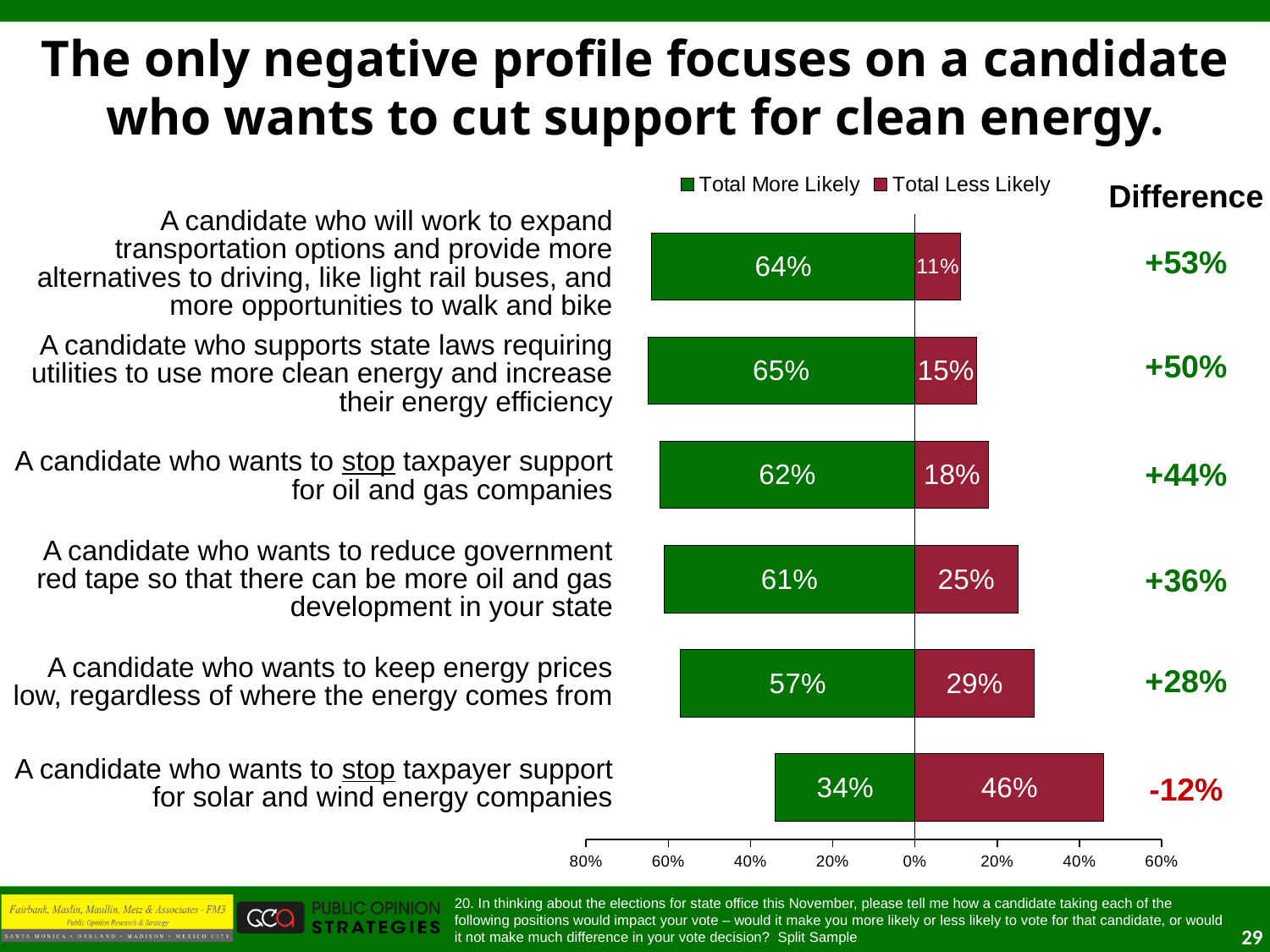
What is the Total Less Likely value for a candidate who wants to stop taxpayer support for solar and wind energy companies? 46% Which colour represents Total Less Likely in the chart? Red Which candidate position has the highest Total More Likely percentage? A candidate who supports state laws requiring utilities to use more clean energy and increase their energy efficiency What percentage of respondents said they would be more likely to vote for a candidate who supports state laws requiring utilities to use more clean energy? 65% What is the difference between Total More Likely and Total Less Likely for a candidate who wants to stop taxpayer support for oil and gas companies? +44% Which candidate position has the lowest Total Less Likely percentage? A candidate who will work to expand transportation options and provide more alternatives to driving Which is larger for a candidate who wants to stop taxpayer support for solar and wind energy companies: Total More Likely or Total Less Likely? Total Less Likely What type of chart is shown on the slide? Bar chart Which candidate position is the only one with a negative Difference value? A candidate who wants to stop taxpayer support for solar and wind energy companies How many candidate positions are shown in the chart? 6 What is the Total Less Likely value for a candidate who wants to keep energy prices low, regardless of where the energy comes from? 29% How many series does the chart legend list? 2